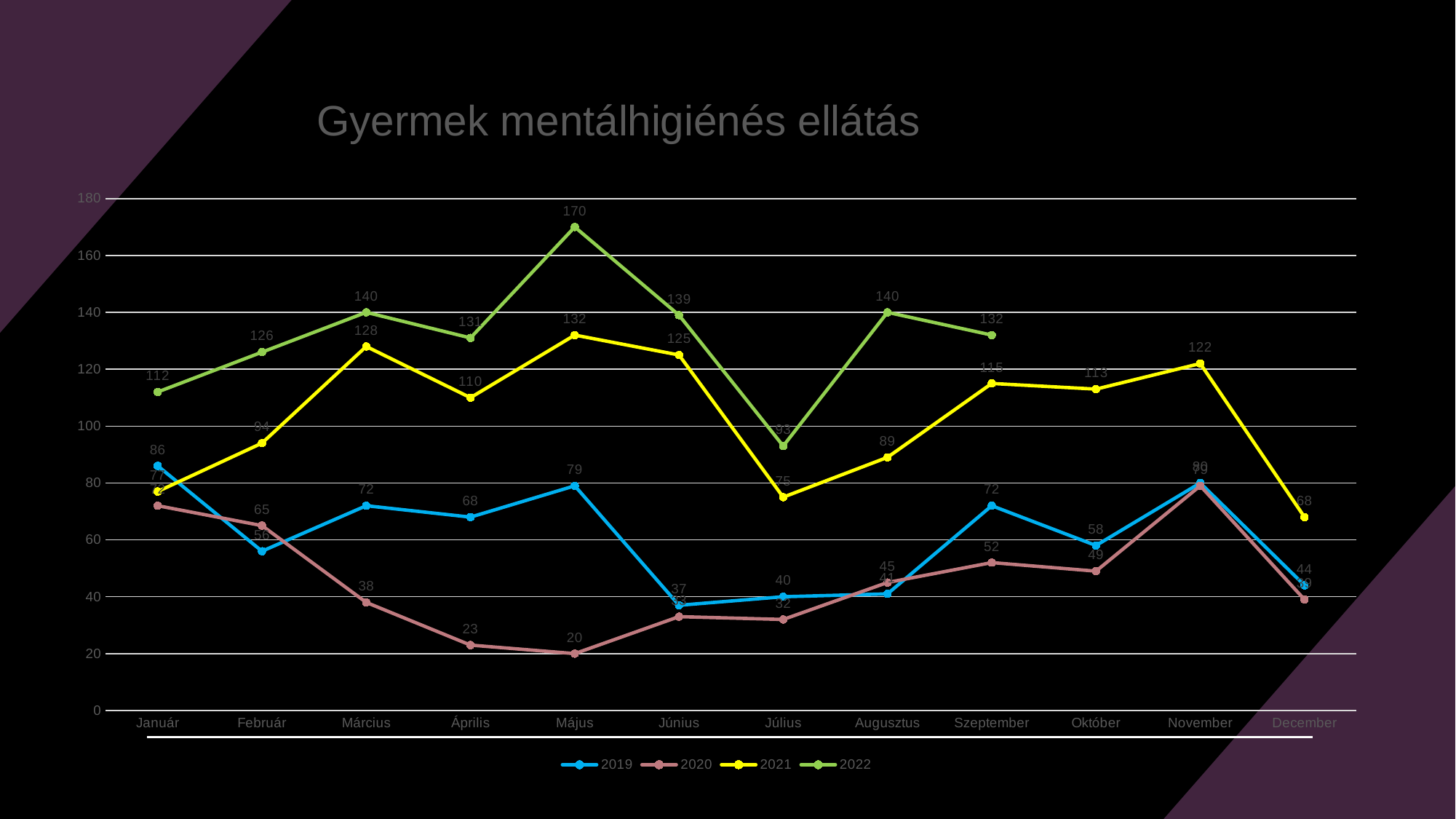
What kind of chart is shown on the slide? line chart What is the value for 2021 in December? 68 How many series does the legend list? 4 Which series has the larger value in Január, 2019 or 2020? 2019 What is the title of the chart? Gyermek mentálhigiénés ellátás What is the value for 2021 in Március? 128 What is the difference between the 2022 and 2021 values in Március? 12 What is the value for 2022 in Május? 170 Is the value for 2020 in Április greater or less than 40? less In which month does the 2022 series reach its highest value? Május How many months are shown along the x axis? 12 In which month does the 2020 series have its lowest value? Május